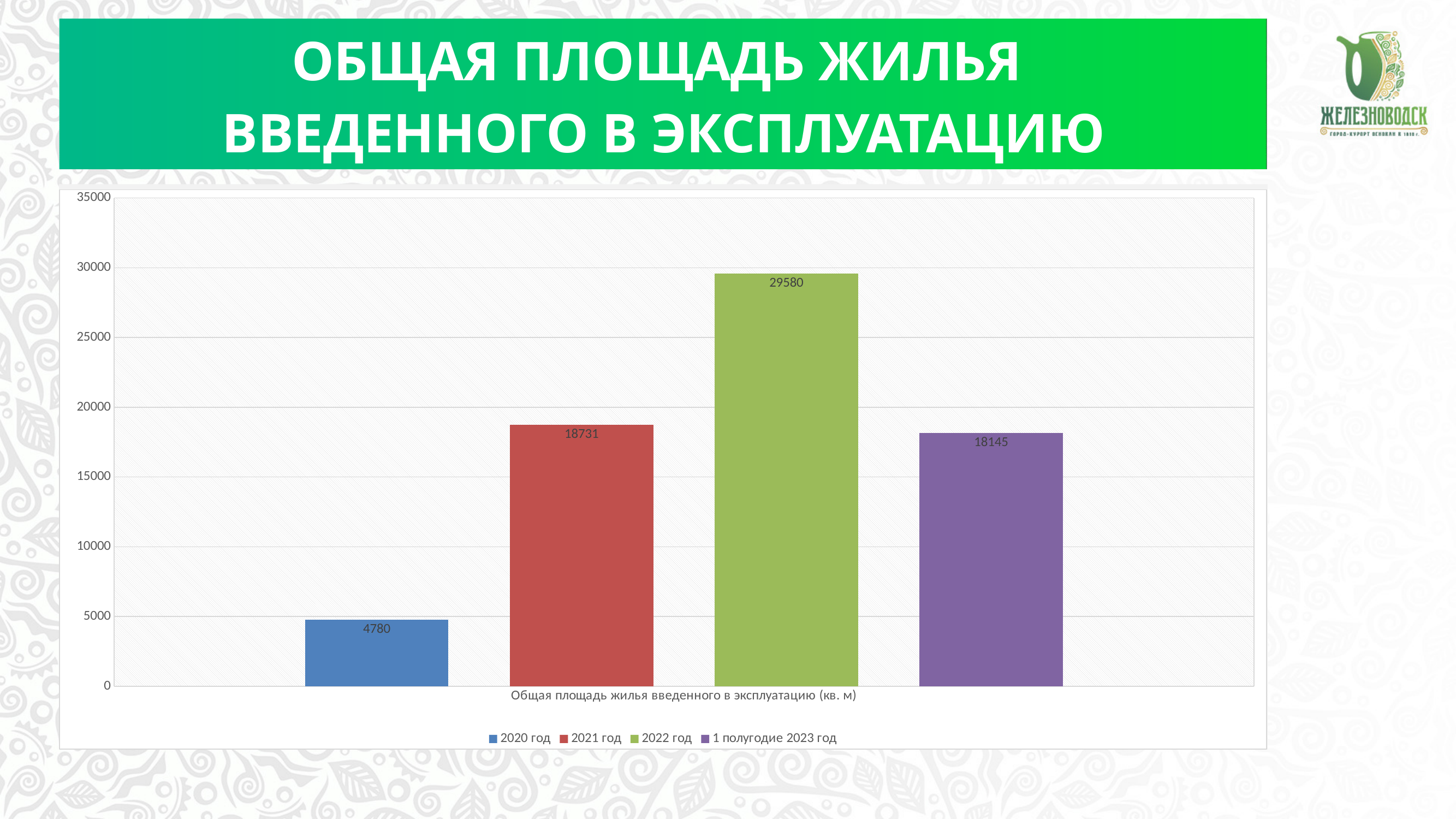
What is the difference between the values for 2021 год and 2020 год? 13951 Is the value for 2022 год greater or less than 25000? greater What is the value for 2021 год? 18731 What is the value for 2022 год? 29580 What kind of chart is shown on the slide? bar chart What is the value for 2020 год? 4780 What is the value for 1 полугодие 2023 год? 18145 What is the difference between the values for 2022 год and 2021 год? 10849 Which series has the lowest value? 2020 год Which series has the highest value? 2022 год Which is larger, the value for 2021 год or the value for 1 полугодие 2023 год? 2021 год How many series does the legend list? 4